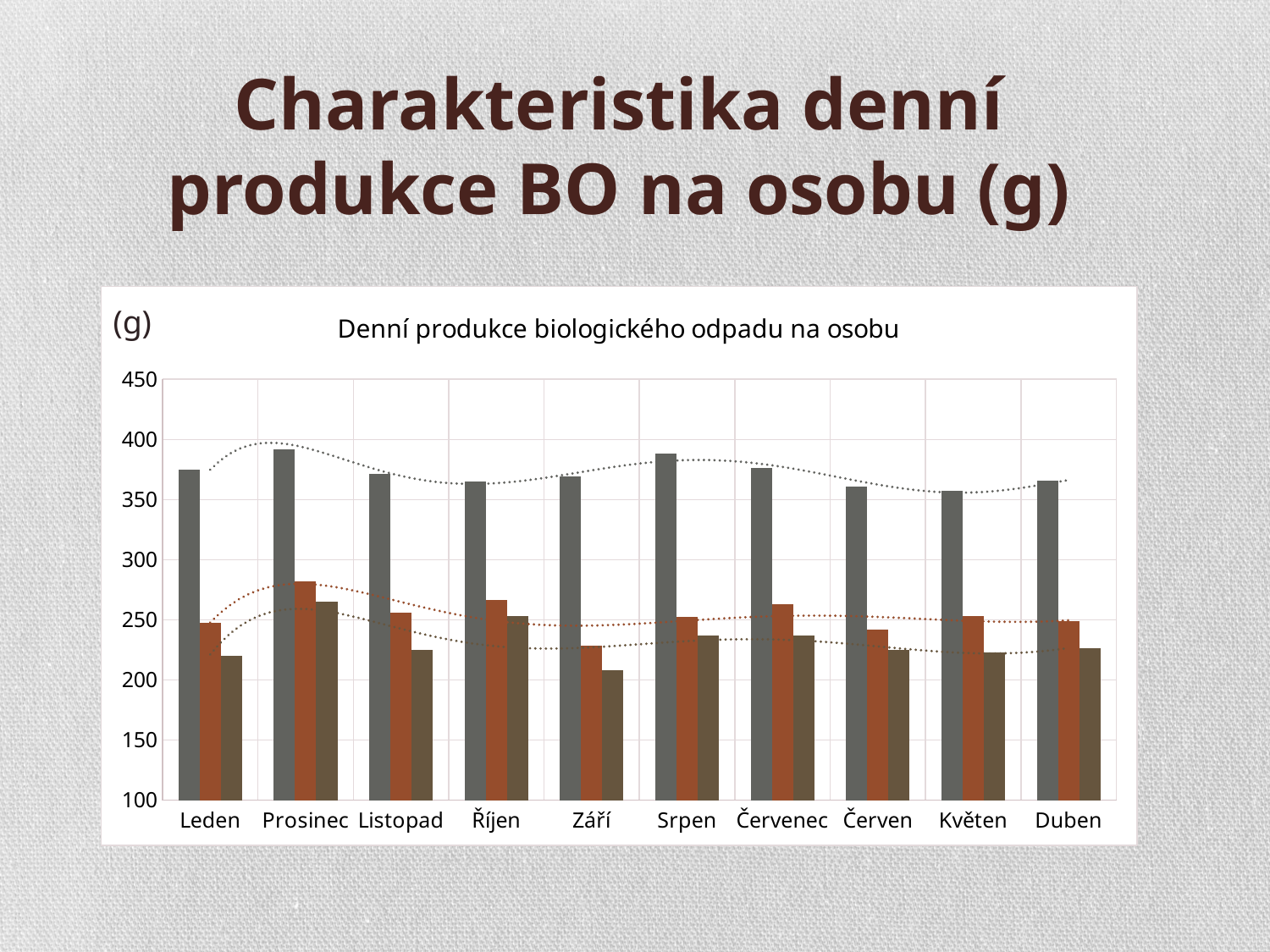
What is the title of the chart? Denní produkce biologického odpadu na osobu Among the dark brown bars, which month has the lowest value? Září Is the value of the dark brown bar for Září greater or less than 250? less What unit is shown at the top of the vertical axis of the chart? (g) Is the value of the grey bar for Duben greater or less than 400? less Is the value of the grey bar for Leden greater or less than 350? greater Which is larger: the orange bar for Září or the orange bar for Říjen? Říjen What kind of chart is shown on the slide? bar chart How many categories (months) are shown on the x axis of the chart? 10 Among the orange bars, which month has the highest value? Prosinec Which is larger: the grey bar for Leden or the grey bar for Prosinec? Prosinec